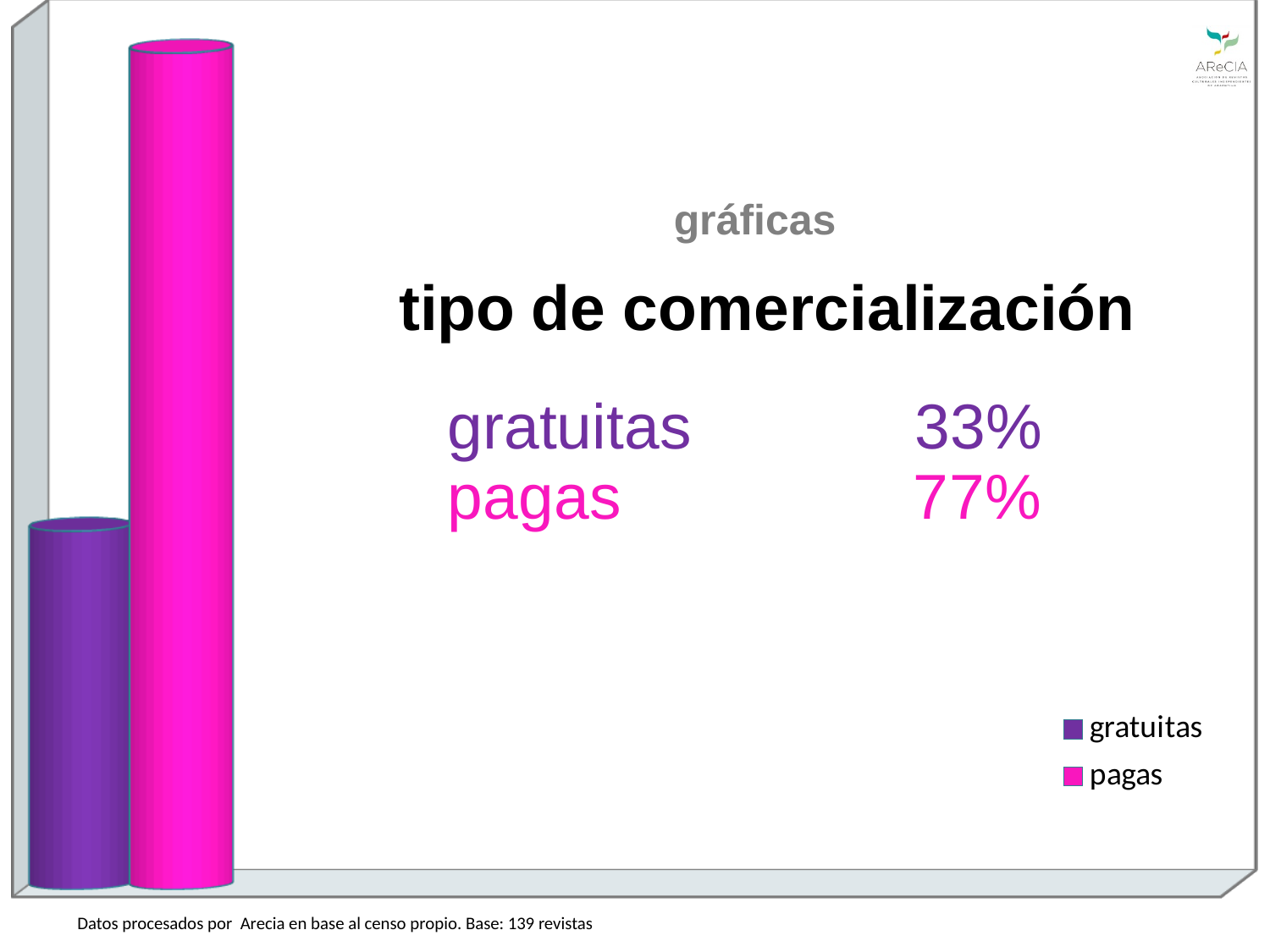
What kind of chart is shown on the slide? bar chart Is the bar for pagas taller or shorter than the bar for gratuitas? taller What percentage is shown for gratuitas? 33% Which category has the shortest bar? gratuitas How many series does the legend list? 2 What is the difference between the percentages shown for pagas and gratuitas? 44% How many bars are plotted in the chart? 2 What percentage is shown for pagas? 77% Which category has the tallest bar, gratuitas or pagas? pagas What colour is the bar for pagas? magenta (pink) What is the title of the chart on the slide? tipo de comercialización